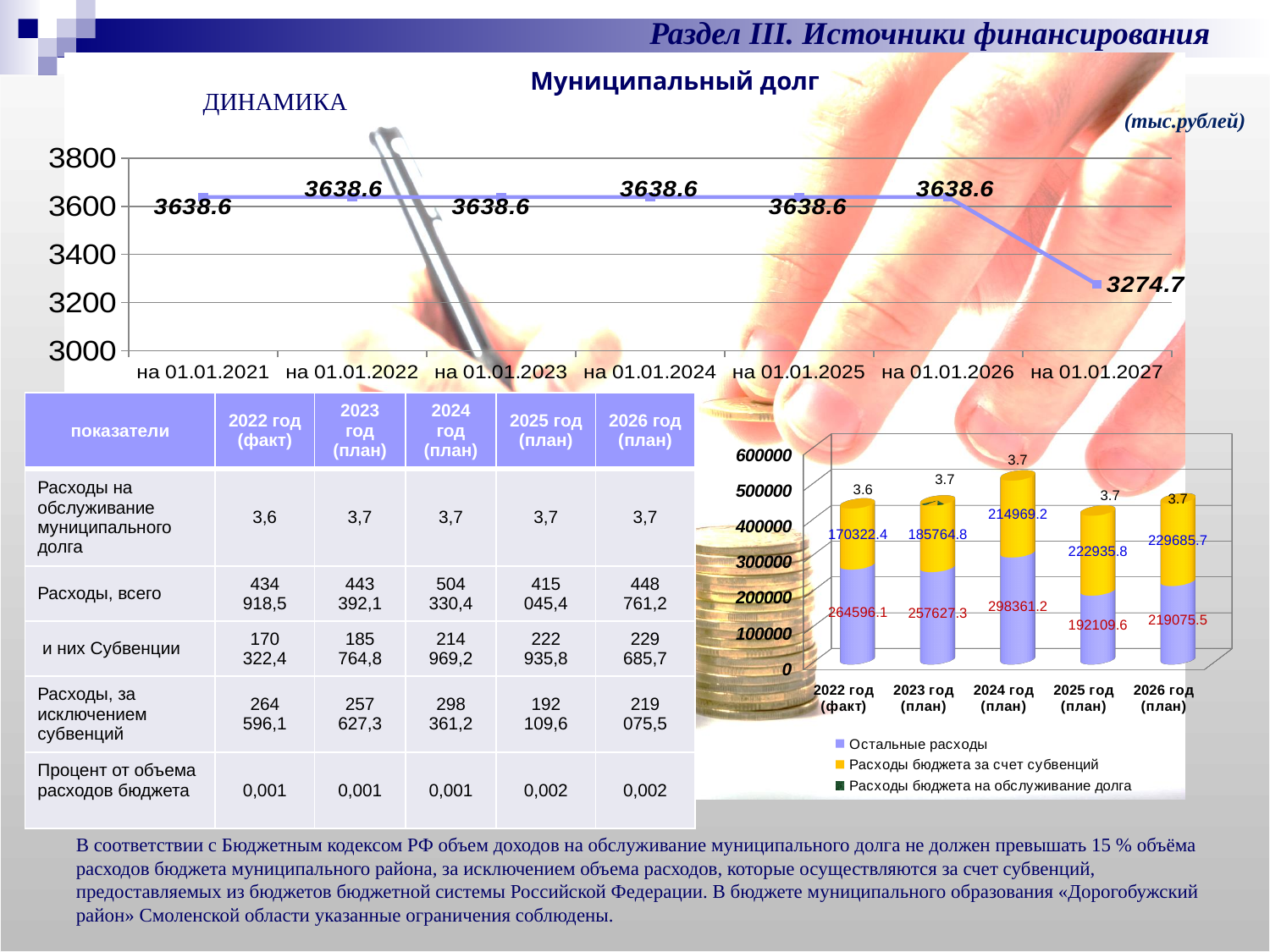
On the line chart 'Муниципальный долг', what is the value for на 01.01.2021? 3638.6 On the line chart 'Муниципальный долг', which date has the lowest value? на 01.01.2027 On the stacked bar chart at the bottom right, do the values of 'Расходы бюджета за счет субвенций' rise or fall from 2022 год (факт) to 2026 год (план)? Rise On the line chart 'Муниципальный долг', what is the difference between the values for на 01.01.2026 and на 01.01.2027? 363.9 On the stacked bar chart at the bottom right, what is the value of 'Расходы бюджета за счет субвенций' for 2026 год (план)? 229685.7 On the line chart 'Муниципальный долг', what is the value for на 01.01.2027? 3274.7 What kind of chart is the 'Муниципальный долг' chart at the top of the slide? Line chart On the stacked bar chart at the bottom right, which year has the highest value of 'Остальные расходы'? 2024 год (план) How many series does the legend of the stacked bar chart at the bottom right list? 3 On the stacked bar chart at the bottom right, what is the value of 'Расходы бюджета на обслуживание долга' for 2022 год (факт)? 3.6 On the line chart 'Муниципальный долг', how many data points are plotted? 7 On the stacked bar chart at the bottom right, what is the value of 'Остальные расходы' for 2024 год (план)? 298361.2